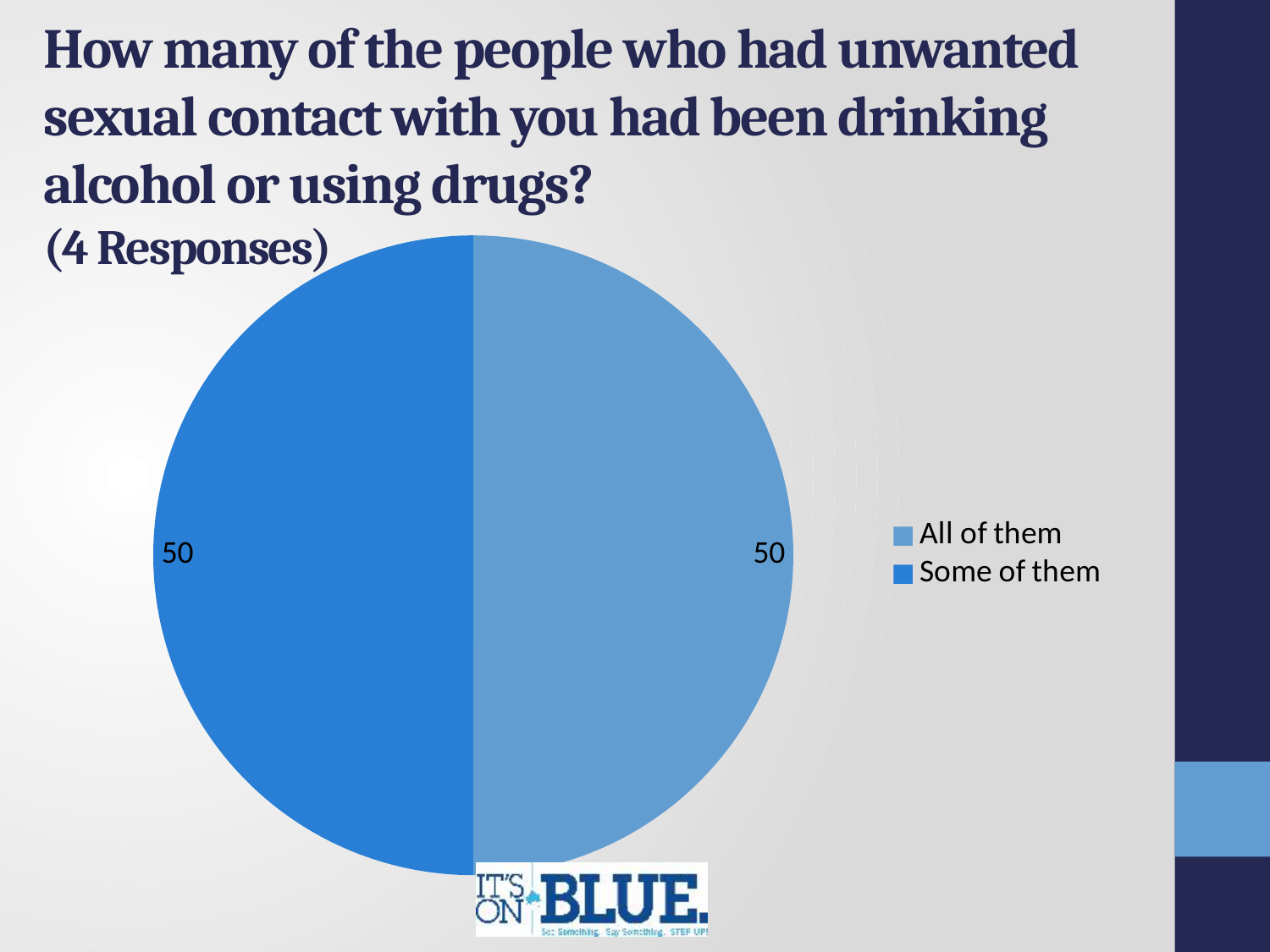
How many entries does the legend list? 2 What share of the pie does the "All of them" slice take? 50% What is the value for "All of them"? 50 What is the total of the two slice values? 100 How many responses does the slide say the chart is based on? 4 What share of the pie does the "Some of them" slice take? 50% Which legend entry is shown in the darker blue colour? Some of them What kind of chart is shown on the slide? pie chart What is the difference between the values for "All of them" and "Some of them"? 0 How many slices does the pie chart have? 2 What is the value for "Some of them"? 50